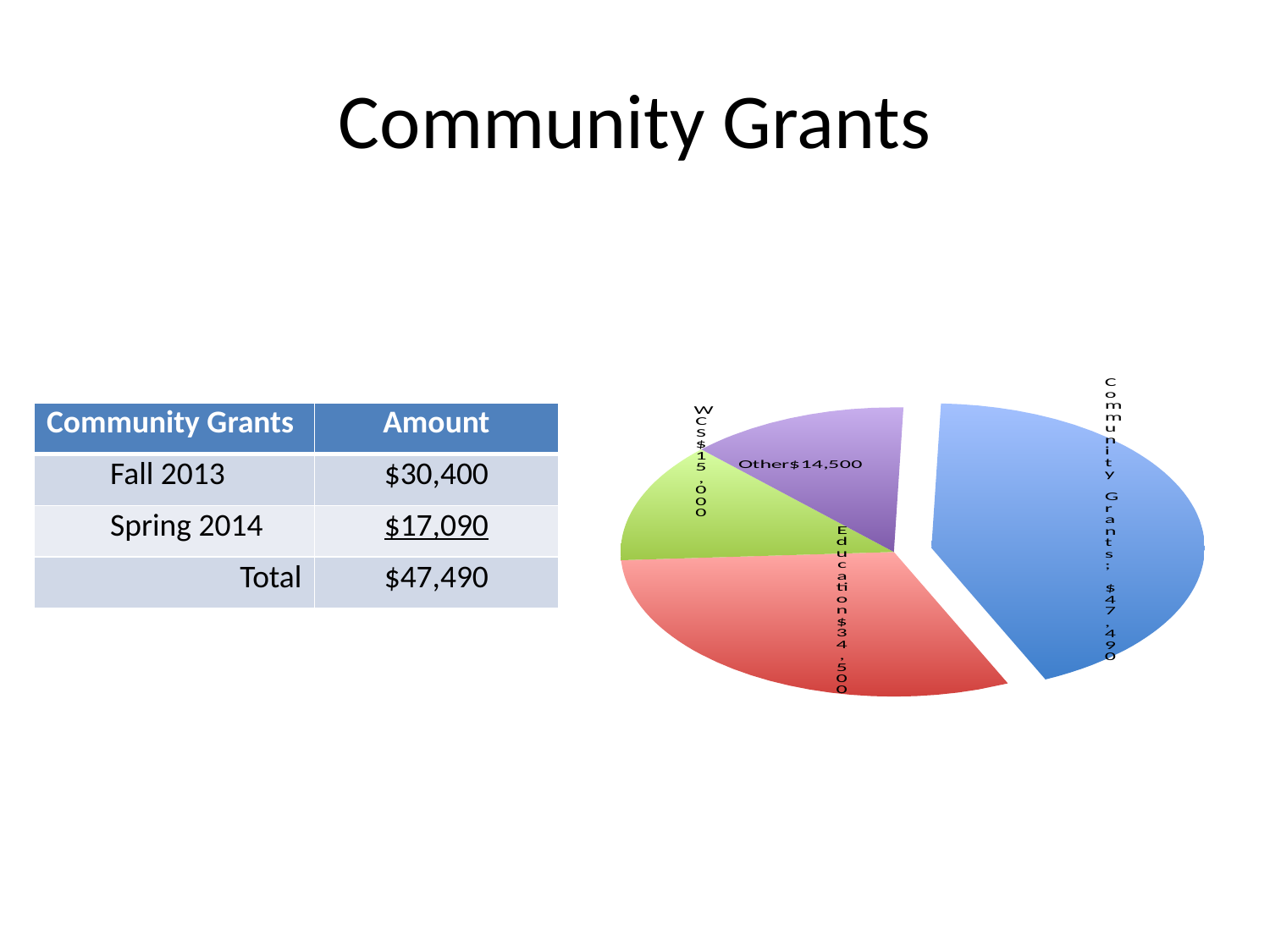
What is the value shown for the WCS slice of the pie chart? $15,000 What is the value shown for the Education slice of the pie chart? $34,500 How many slices does the pie chart have? 4 Which slice of the pie chart has the smallest value? Other Which slice of the pie chart is pulled out (exploded) from the rest of the pie? Community Grants What type of chart is shown on the slide? pie chart Which is larger in the pie chart, the WCS slice or the Other slice? WCS Which slice of the pie chart has the largest value? Community Grants What is the difference between the Education value and the WCS value in the pie chart? $19,500 What is the difference between the Community Grants value and the Education value in the pie chart? $12,990 What is the value shown for the Community Grants slice of the pie chart? $47,490 What is the value shown for the Other slice of the pie chart? $14,500